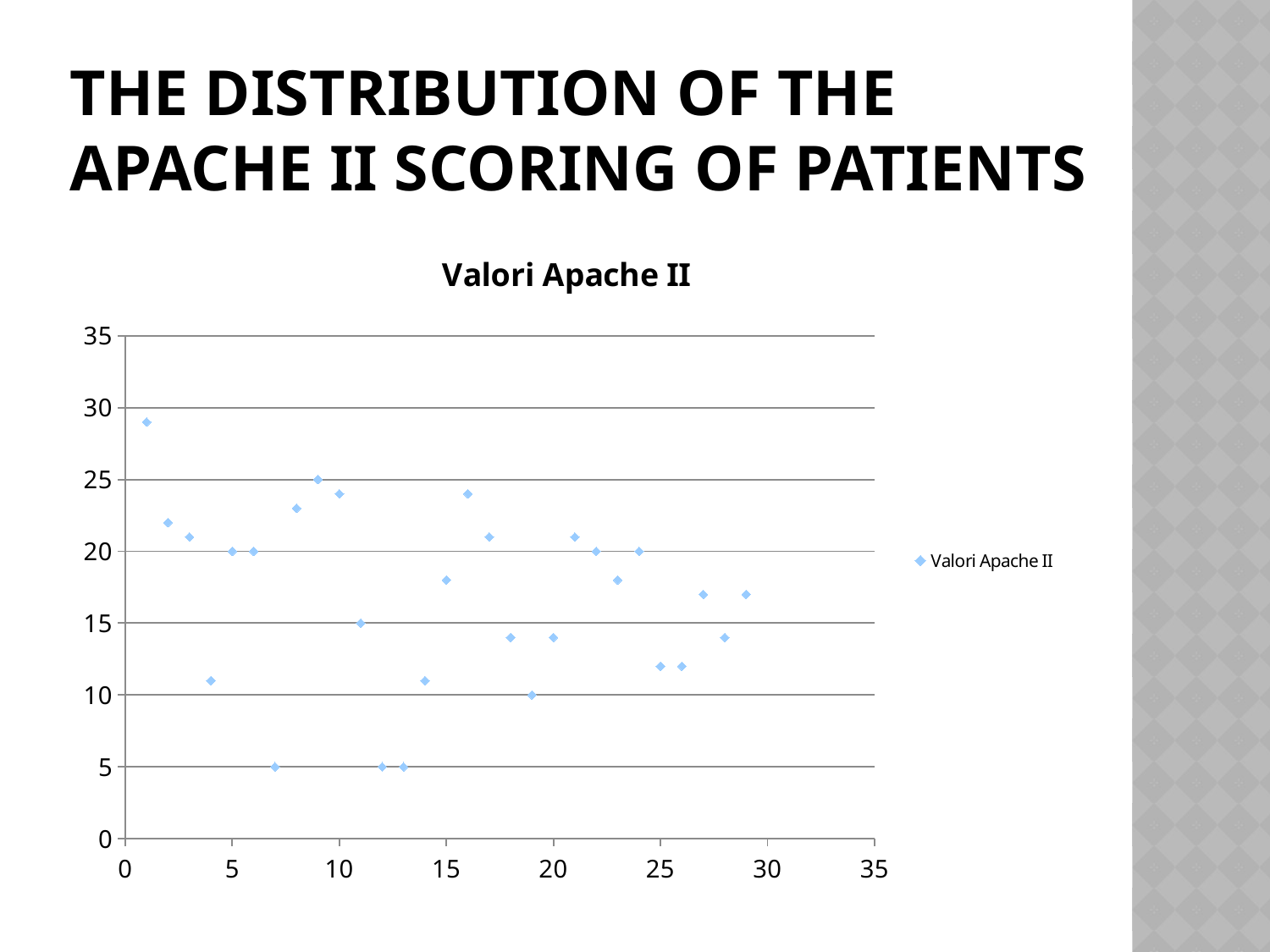
Is the value of the leftmost point (at x = 1) greater or less than 25? greater What kind of chart is shown on the slide? scatter chart What is the title of the chart? Valori Apache II How many series does the legend list? 1 Is the value of the point at x = 20 greater or less than 15? less Is the value of the point at x = 15 greater or less than 20? less Which has the larger value, the point at x = 10 or the point at x = 20? the point at x = 10 What is the value of the point at x = 5? 20 What is the lowest value plotted on the chart? 5 How many data points are plotted in the chart? 29